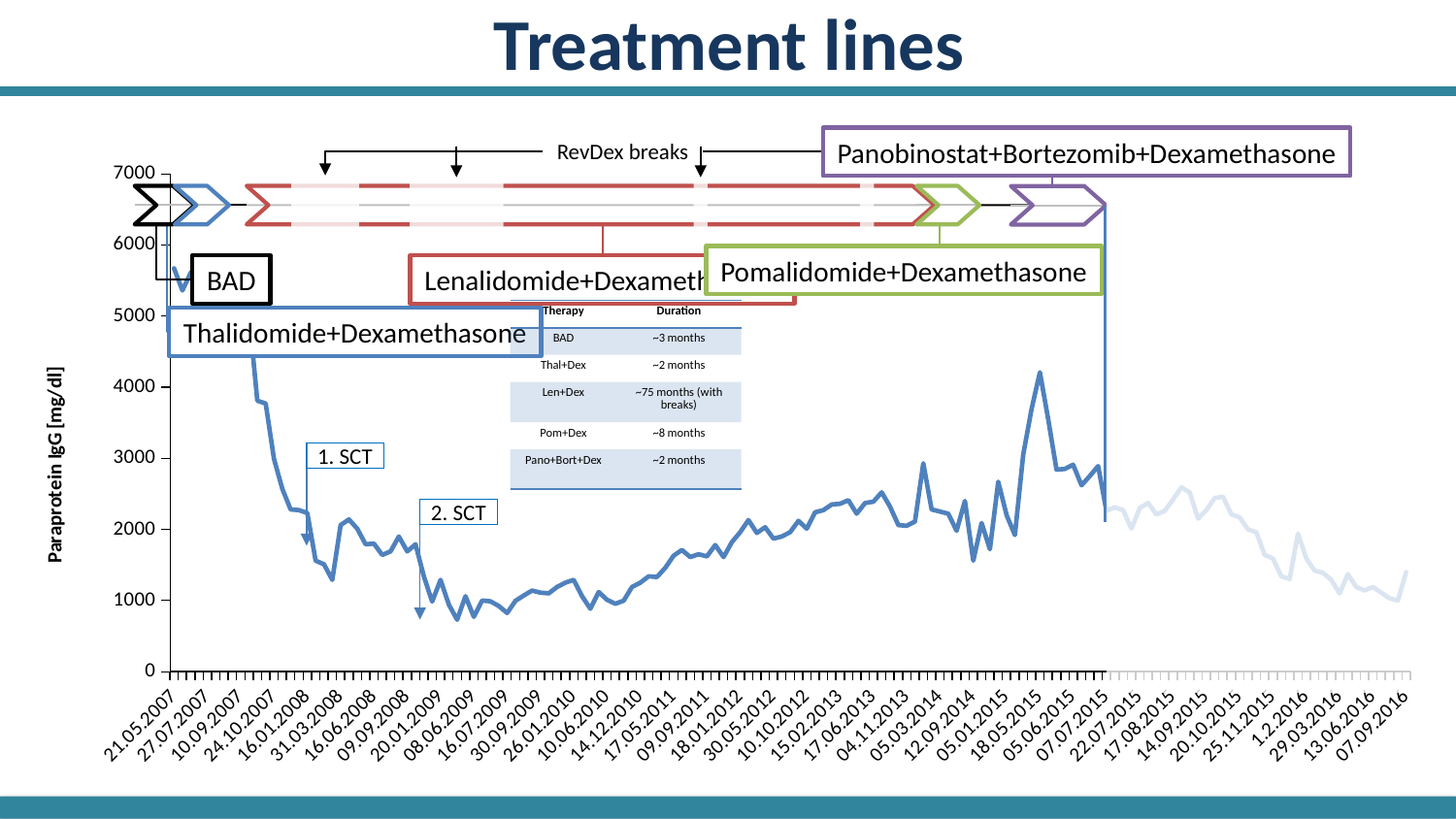
What is the title of the slide containing the chart? Treatment lines Do the paraprotein IgG values rise or fall between 21.05.2007 and 31.03.2008? fall Is the paraprotein IgG value at 20.01.2009 greater or less than 1000? greater Which is larger, the paraprotein IgG value at 24.10.2007 or at 20.01.2009? 24.10.2007 What is the highest value shown on the y axis of the chart? 7000 What kind of chart is shown on the slide? line chart Do the paraprotein IgG values generally rise or fall between 16.07.2009 and 04.11.2013? rise Is the paraprotein IgG value at 07.09.2016 greater or less than 2000? less Is the peak paraprotein IgG value around 18.05.2015 greater or less than 3000? greater What is the label of the y axis of the chart? Paraprotein IgG [mg/dl]